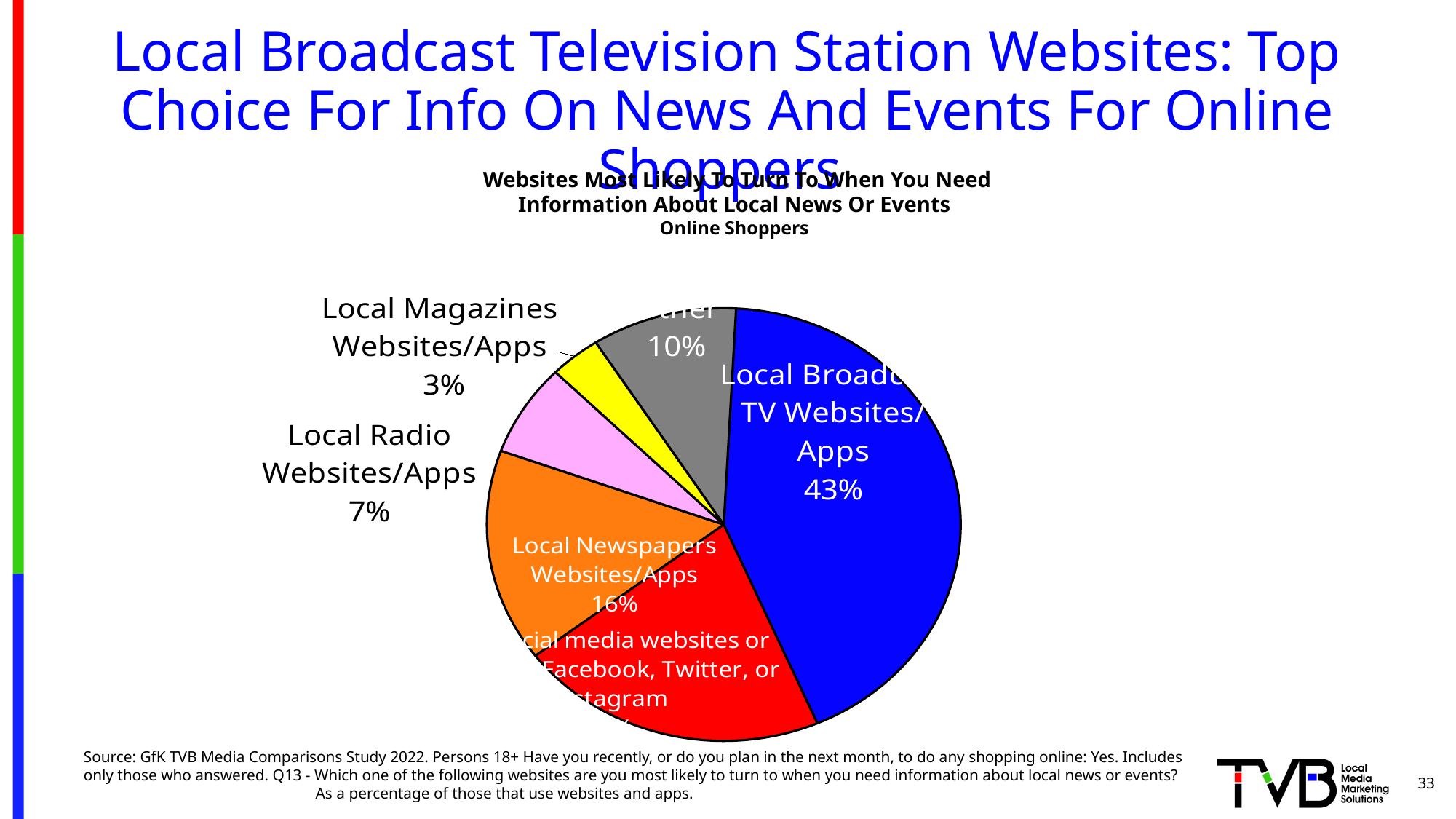
What percentage is shown for Local Magazines Websites/Apps? 3% What kind of chart is shown on the slide? Pie chart Which category has the largest share of the pie? Local Broadcast TV Websites/Apps What percentage of online shoppers are most likely to turn to Local Broadcast TV Websites/Apps for local news or events? 43% How many percentage points larger is Local Broadcast TV Websites/Apps than Local Newspapers Websites/Apps? 27 percentage points Which category has the smallest share of the pie? Local Magazines Websites/Apps How many slices does the pie chart have? 6 What percentage is shown for the Other slice? 10% What colour is the Local Broadcast TV Websites/Apps slice? Blue What share of the pie is Local Newspapers Websites/Apps? 16% Which is larger, the share for Local Radio Websites/Apps or the share for Other? Other What percentage is shown for Local Radio Websites/Apps? 7%